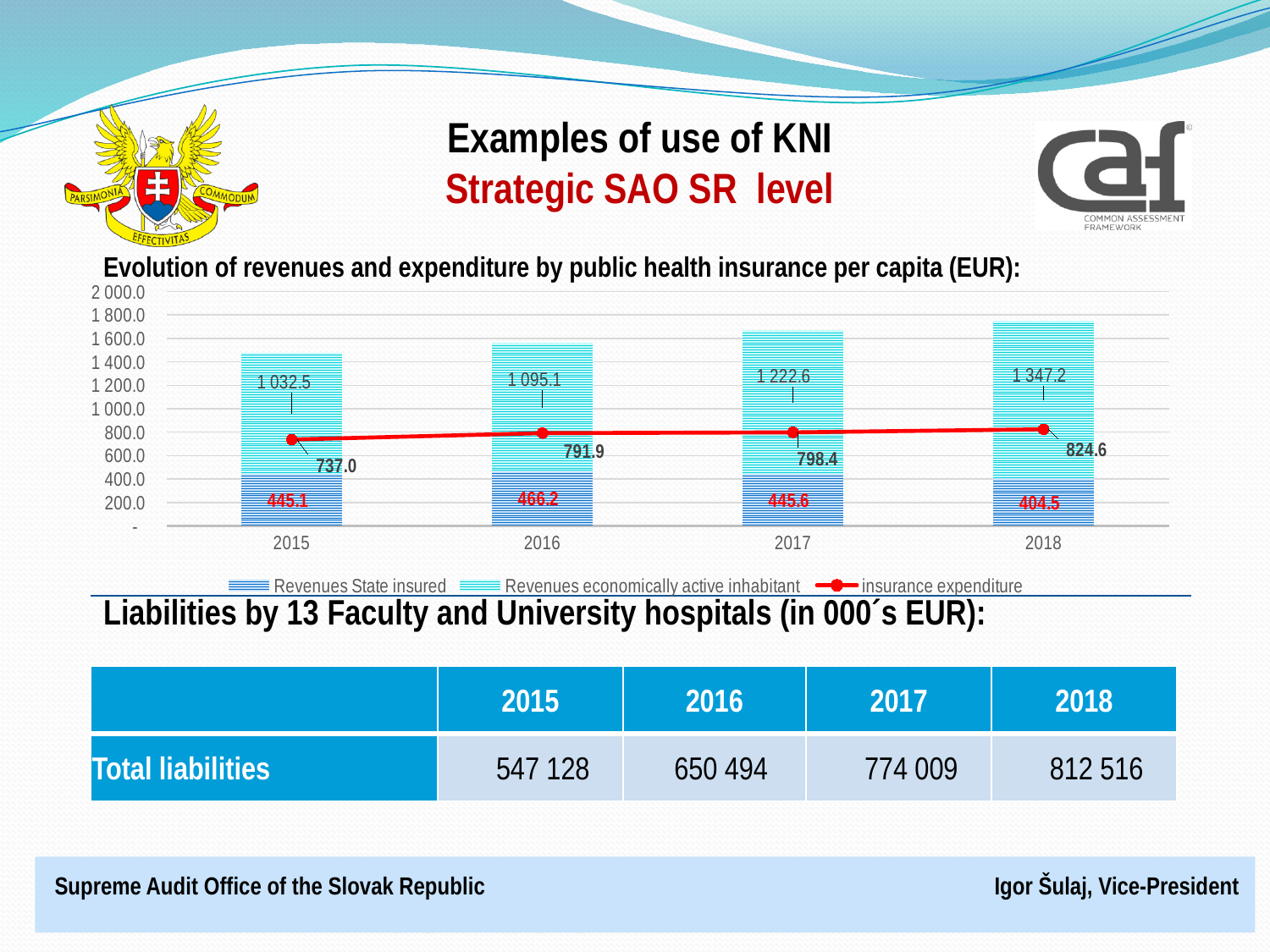
What is the insurance expenditure value in 2016? 791.9 What is the difference between Revenues economically active inhabitant in 2018 and in 2015? 314.7 What is the total of the stacked bar for 2016? 1 561.3 What is the value for Revenues State insured in 2018? 404.5 In which year is insurance expenditure lowest? 2015 Does insurance expenditure rise or fall from 2015 to 2018? Rise How many years are shown on the x axis of the chart? 4 What is the value for Revenues economically active inhabitant in 2017? 1 222.6 What kind of chart is shown on the slide? Stacked bar chart with a line In which year is Revenues State insured highest? 2016 How many series does the chart legend list? 3 Which is larger: insurance expenditure in 2017 or Revenues State insured in 2017? insurance expenditure in 2017